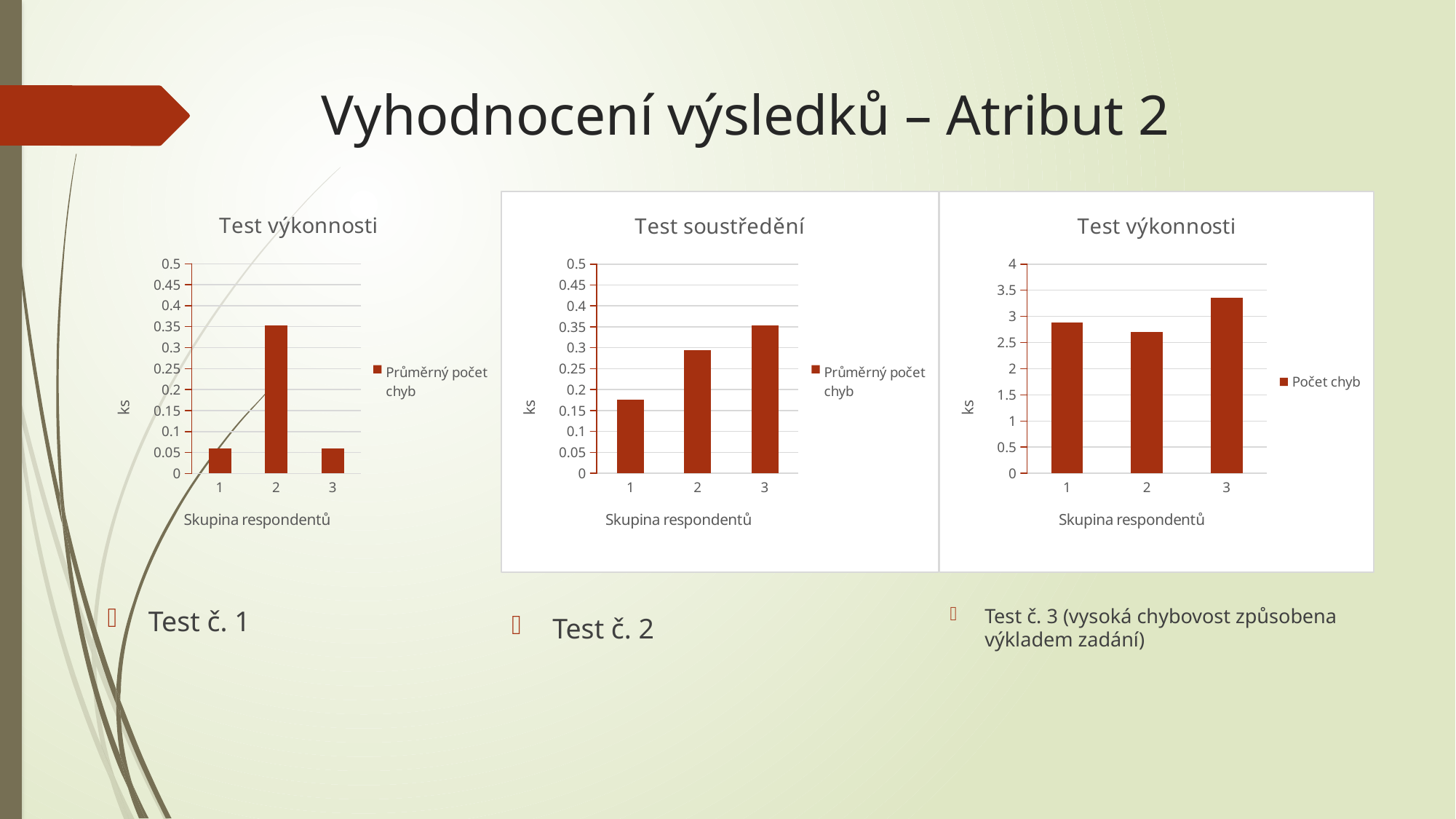
In the left chart titled 'Test výkonnosti', is the value for group 2 greater or less than 0.3? greater In the middle chart titled 'Test soustředění', is the value for group 1 greater or less than 0.2? less In the right chart titled 'Test výkonnosti', which is larger, the value for group 2 or the value for group 3? group 3 What is the legend entry of the right chart titled 'Test výkonnosti'? Počet chyb In the left chart titled 'Test výkonnosti', is the value for group 1 greater or less than 0.1? less In the right chart titled 'Test výkonnosti', which group of respondents has the highest number of errors? 3 In the middle chart titled 'Test soustředění', which group of respondents has the lowest average number of errors? 1 In the left chart titled 'Test výkonnosti', which group of respondents has the highest value? 2 In the middle chart titled 'Test soustředění', do the values rise or fall from group 1 to group 3? rise How many groups of respondents are shown on the x axis of the middle chart titled 'Test soustředění'? 3 In the middle chart titled 'Test soustředění', which group of respondents has the highest average number of errors? 3